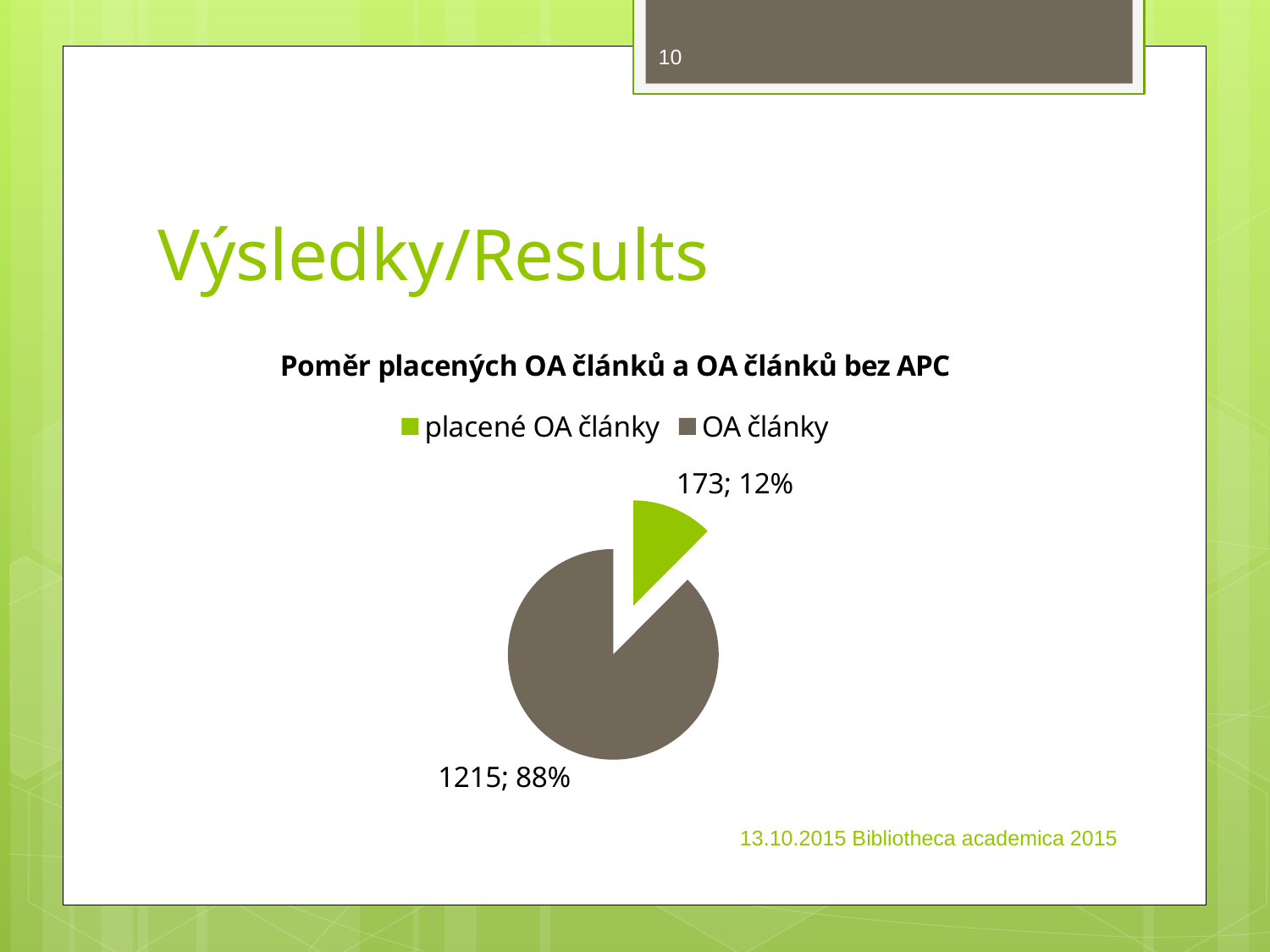
What is the difference between the values for OA články and placené OA články? 1042 How many series does the legend list? 2 What is the title of the chart? Poměr placených OA článků a OA článků bez APC Which category has the largest slice? OA články What is the value for OA články? 1215 How many slices does the pie chart have? 2 What share of the pie does placené OA články represent? 12% What is the value for placené OA články? 173 What kind of chart is shown on the slide? pie chart What share of the pie does OA články represent? 88% Which category has the smallest slice? placené OA články Which colour represents placené OA články in the chart? green